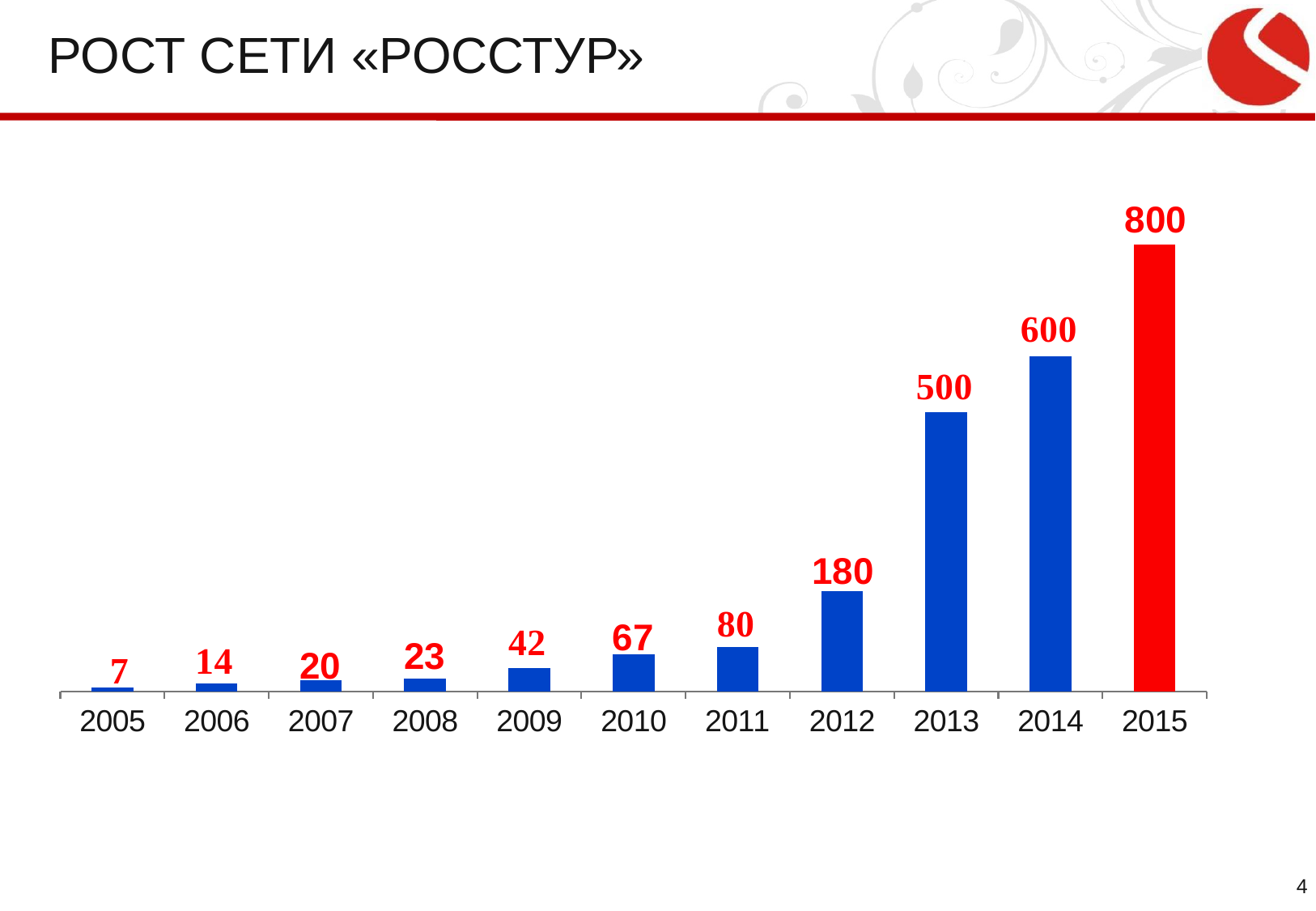
What is the difference between the values for 2013 and 2012? 320 What is the value for 2009? 42 Which is larger, the value for 2010 or the value for 2011? 2011 What is the value for 2012? 180 Which year has the lowest value? 2005 How many years are shown on the x axis? 11 Do the values rise or fall from 2005 to 2015? rise What is the difference between the values for 2015 and 2014? 200 What is the value for 2005? 7 Which year has the highest value? 2015 Which bar is coloured red instead of blue? 2015 What kind of chart is this? bar chart